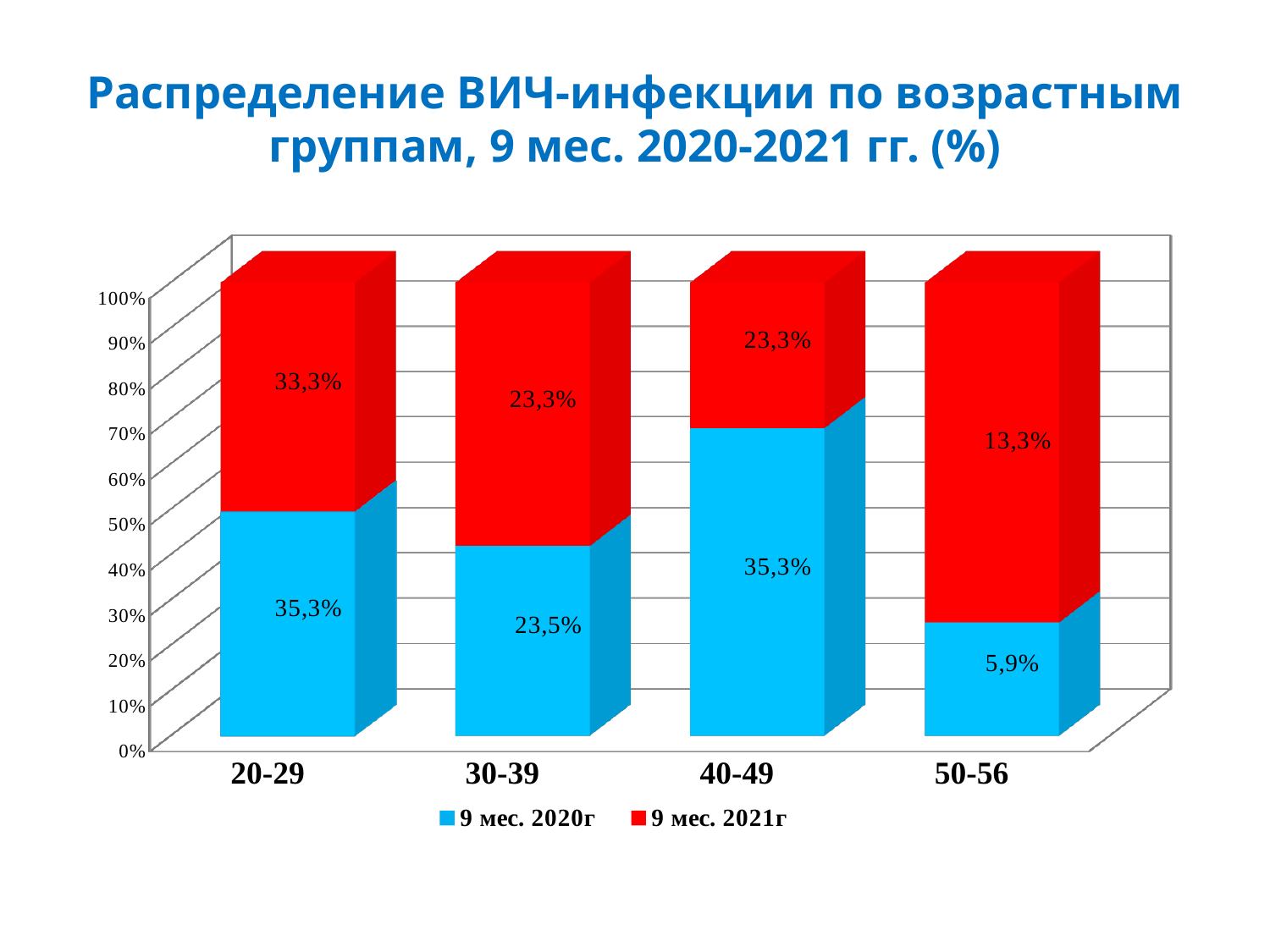
What is the difference between the 9 мес. 2021г and 9 мес. 2020г values for the 50-56 age group? 7,4% What is the value for the 20-29 age group in the 9 мес. 2020г series? 35,3% What is the value for the 50-56 age group in the 9 мес. 2021г series? 13,3% Which age group has the lowest value in the 9 мес. 2020г series? 50-56 How many age groups are shown on the x axis? 4 What kind of chart is shown on the slide? Stacked bar chart Which age group has the lowest value in the 9 мес. 2021г series? 50-56 How many series does the legend list? 2 What is the value for the 30-39 age group in the 9 мес. 2020г series? 23,5% Which age group has the highest value in the 9 мес. 2021г series? 20-29 What is the difference between the 9 мес. 2020г and 9 мес. 2021г values for the 40-49 age group? 12,0% For the 40-49 age group, which series has the larger value: 9 мес. 2020г or 9 мес. 2021г? 9 мес. 2020г